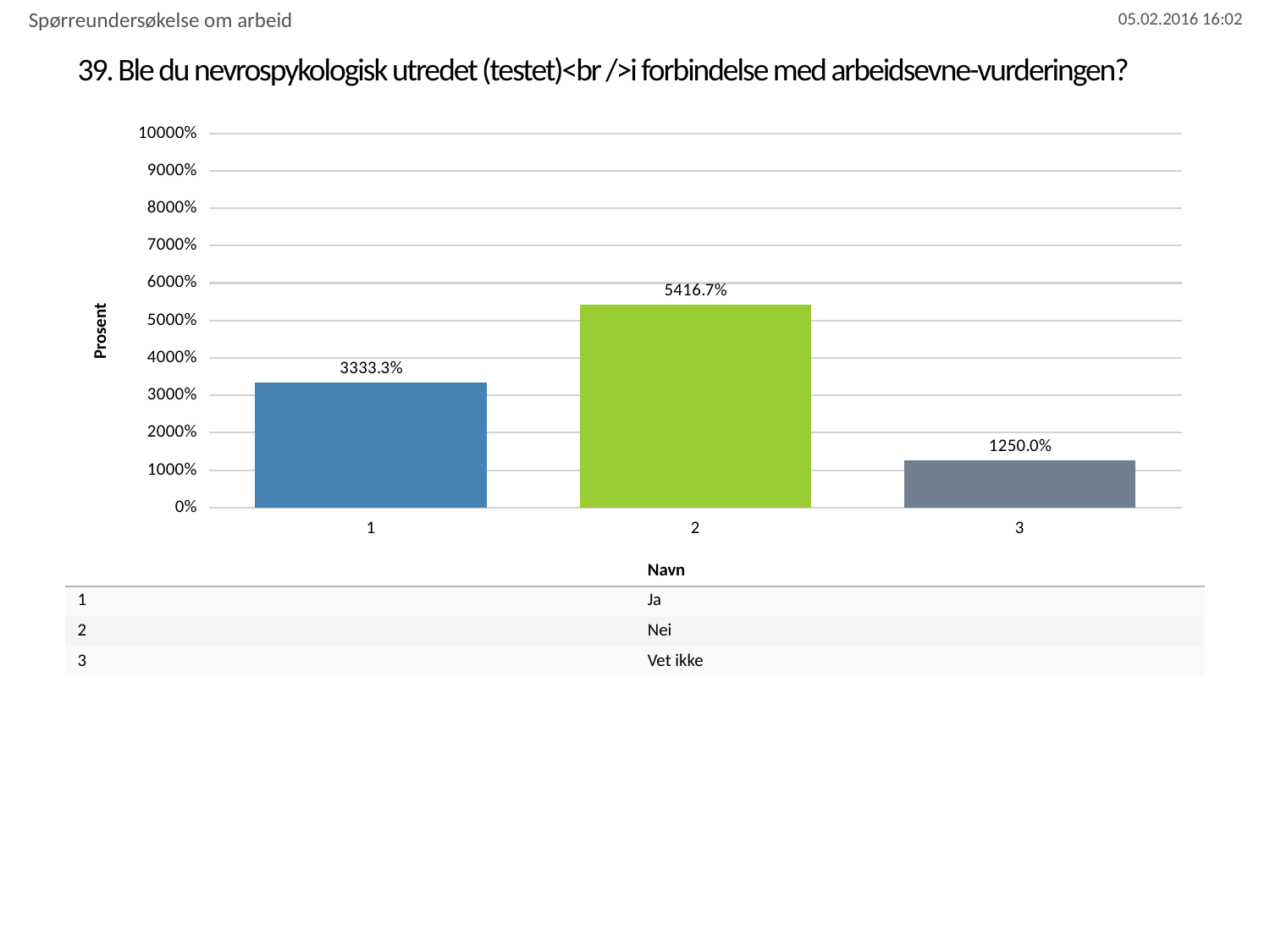
What is the label of the y axis? Prosent What kind of chart is shown? bar chart Which category has the highest value? 2 What is the value for category 2? 5416.7% What is the value for category 1? 3333.3% What is the value for category 3? 1250.0% According to the table below the chart, what name corresponds to category 3? Vet ikke Which category has the lowest value? 3 Is the value for category 2 greater or less than 5000%? greater Which is larger, the value for category 1 or category 3? 1 What is the difference between the values for category 2 and category 1? 2083.4% How many categories are shown on the x axis? 3